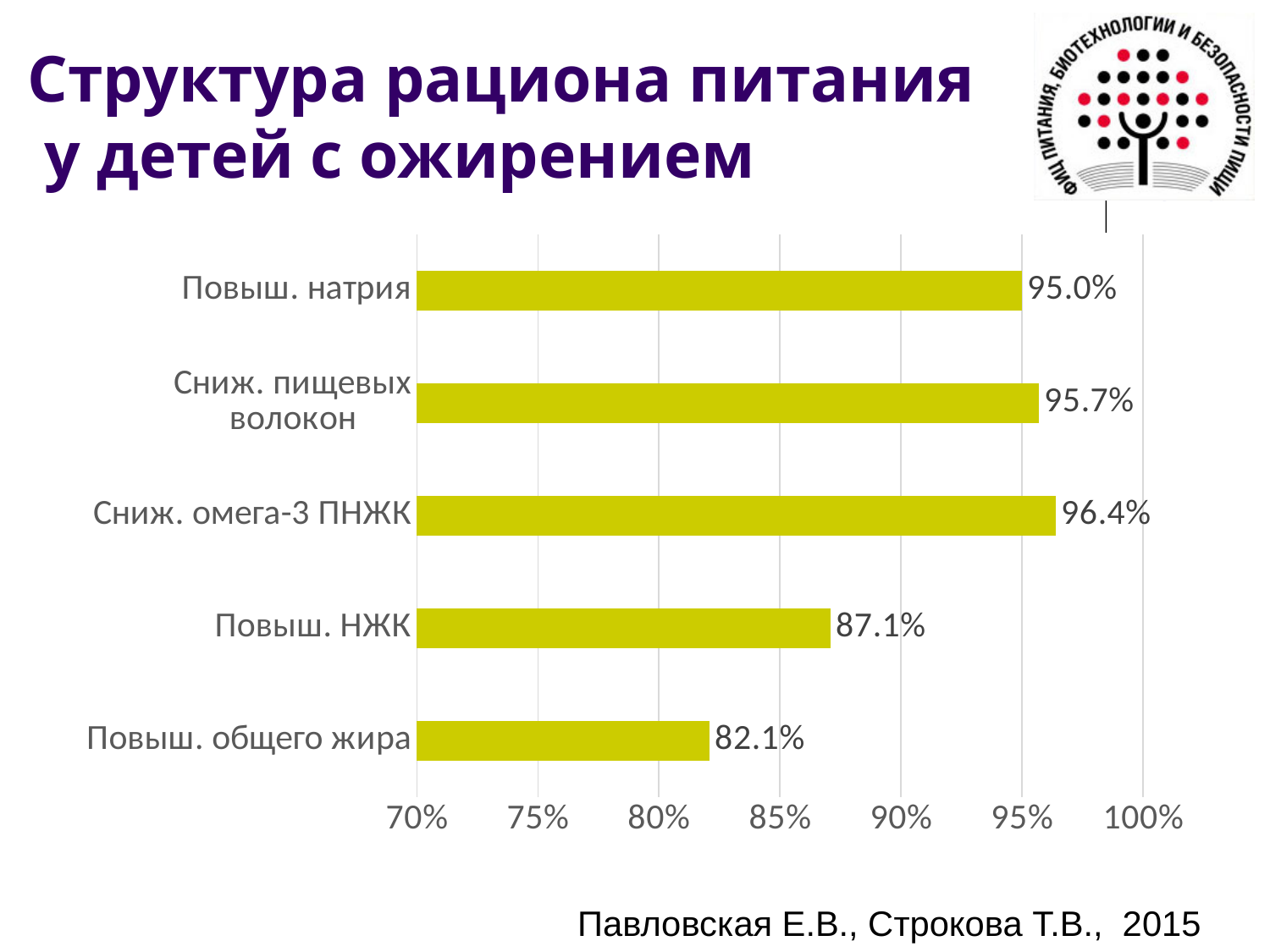
How many categories are shown in the chart? 5 Is the value for Повыш. общего жира greater or less than 85%? less Which category has the lowest value? Повыш. общего жира What is the value for Повыш. НЖК? 87.1% What is the value for Сниж. омега-3 ПНЖК? 96.4% Which category has the highest value? Сниж. омега-3 ПНЖК What kind of chart is shown on the slide? bar chart What is the difference between the values for Повыш. НЖК and Повыш. общего жира? 5.0% What is the value for Повыш. общего жира? 82.1% What is the value for Повыш. натрия? 95.0% What is the value for Сниж. пищевых волокон? 95.7% Which is larger, the value for Повыш. натрия or the value for Повыш. НЖК? Повыш. натрия